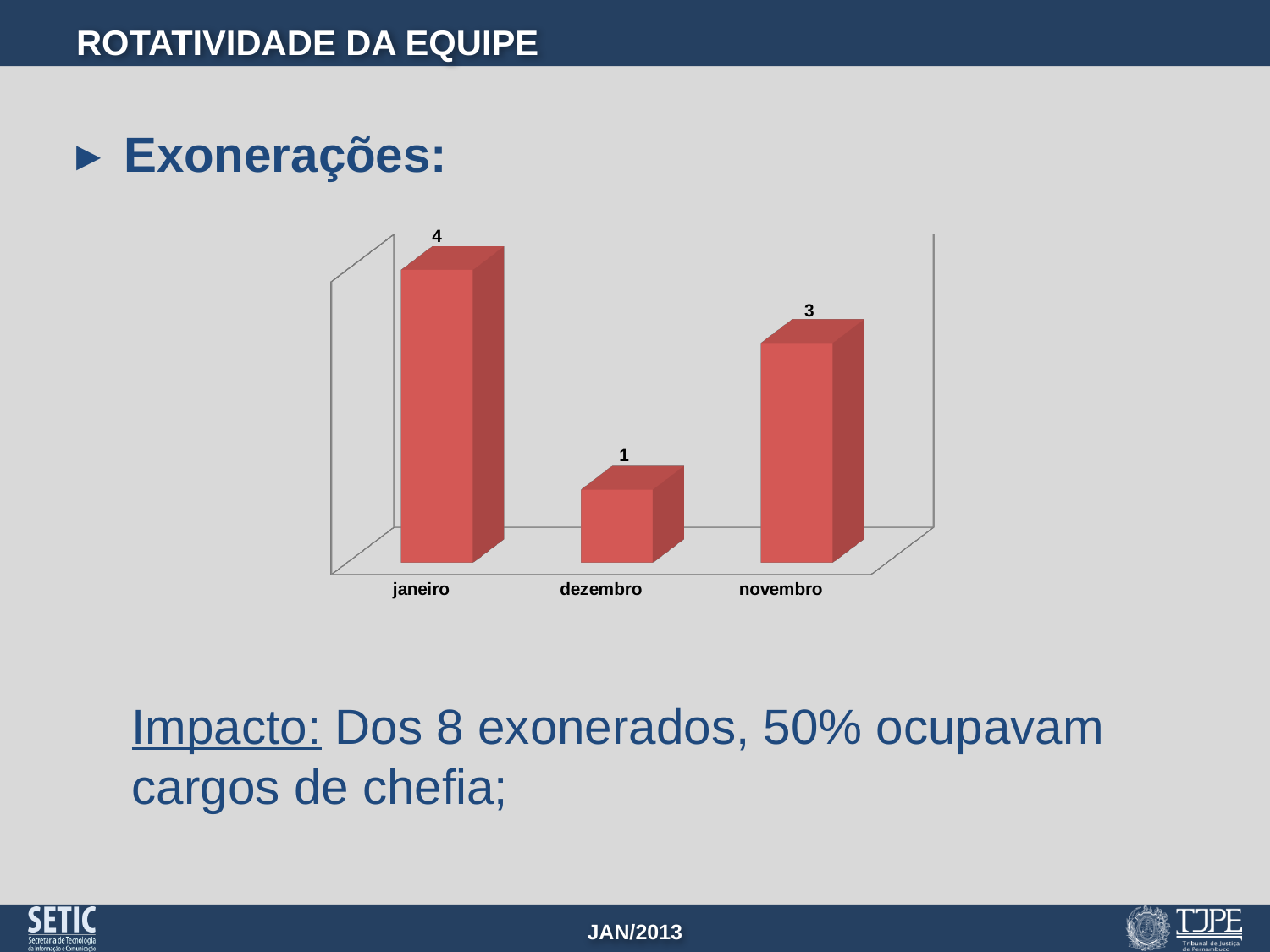
Which category has the highest value? janeiro How many categories are shown on the x axis? 3 What is the value for novembro? 3 What colour are the bars in the chart? red What is the total of the three values plotted in the chart? 8 What kind of chart is shown on the slide? bar chart What is the difference between the values for novembro and dezembro? 2 What is the value for dezembro? 1 Which is larger, the value for janeiro or the value for dezembro? janeiro What is the difference between the values for janeiro and novembro? 1 What is the value for janeiro? 4 Which category has the lowest value? dezembro